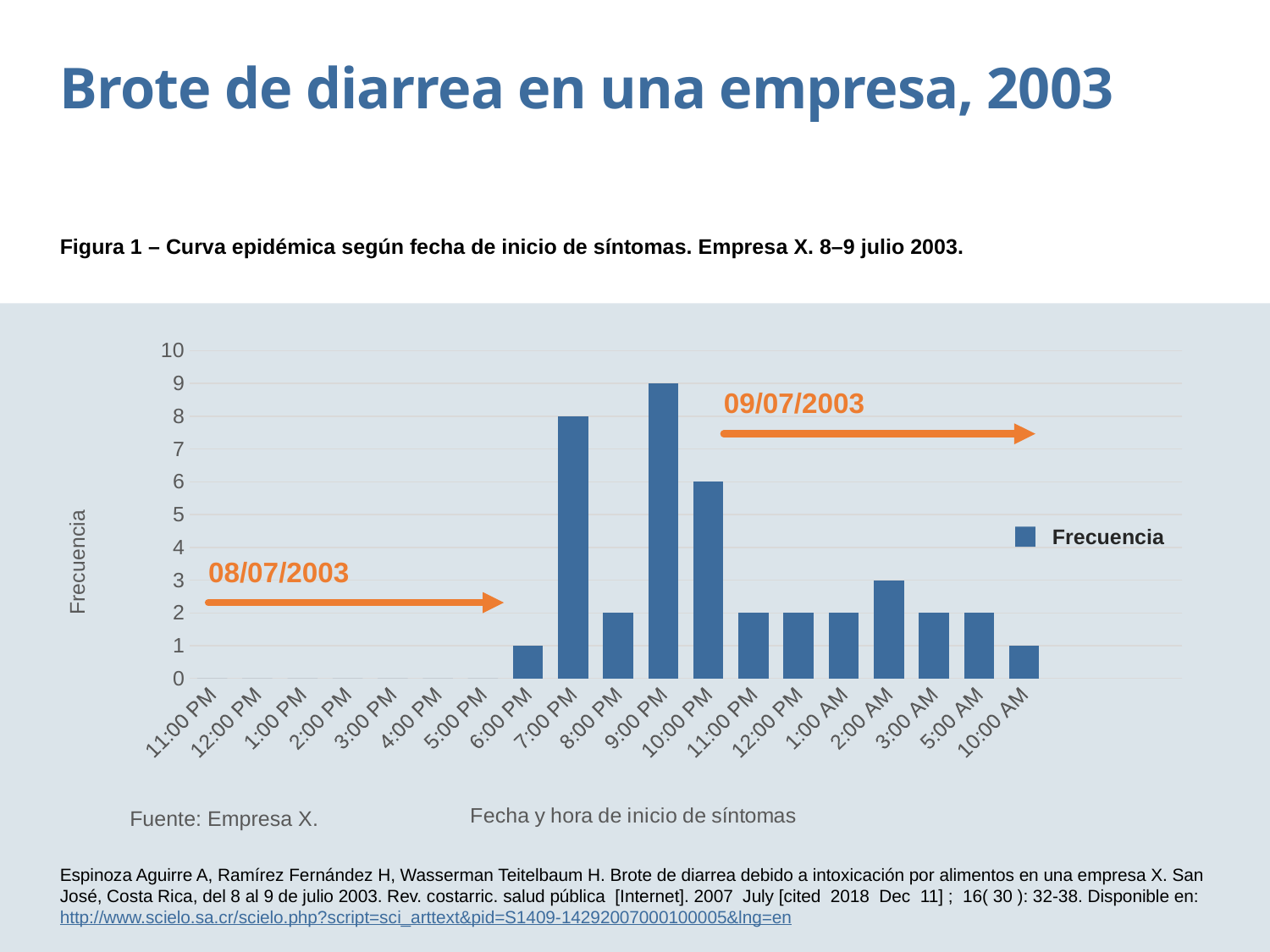
What is the frequency value for 2:00 AM? 3 Which has a higher frequency, 10:00 PM or 2:00 AM? 10:00 PM Which time has the highest frequency? 9:00 PM What is the frequency value for 7:00 PM? 8 What is the frequency value for 10:00 PM? 6 What is the difference between the frequency at 9:00 PM and at 7:00 PM? 1 What type of chart is shown on the slide? bar chart What is the frequency value for 9:00 PM? 9 What is the name of the series shown in the legend? Frecuencia What is the frequency value for 10:00 AM? 1 Is the frequency value for 7:00 PM greater or less than 5? greater How many series does the legend list? 1